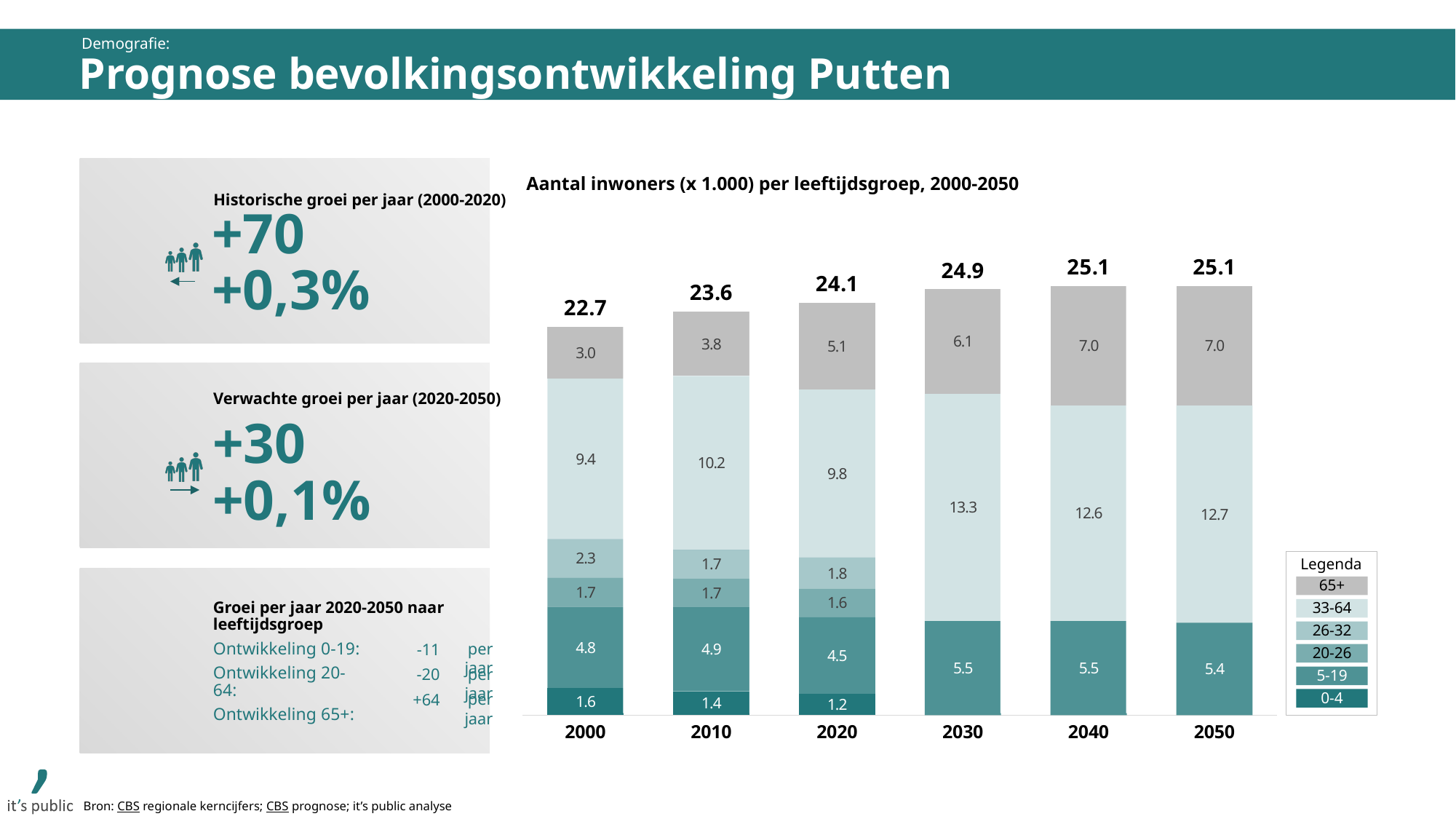
What is the value of the 65+ segment for 2050? 7.0 Which year has the larger 33-64 value, 2010 or 2020? 2010 What kind of chart is shown? Stacked bar chart Do the total values rise or fall from 2000 to 2050? Rise What is the difference between the 65+ value in 2050 and the 65+ value in 2000? 4.0 How many years are shown on the x axis? 6 Which year has the lowest total number of inhabitants? 2000 How many age groups does the legend list? 6 What is the total number of inhabitants (x 1.000) shown for 2000? 22.7 What is the value of the 33-64 segment for 2030? 13.3 What is the difference between the total for 2010 and the total for 2000? 0.9 What is the value of the 0-4 segment for 2020? 1.2